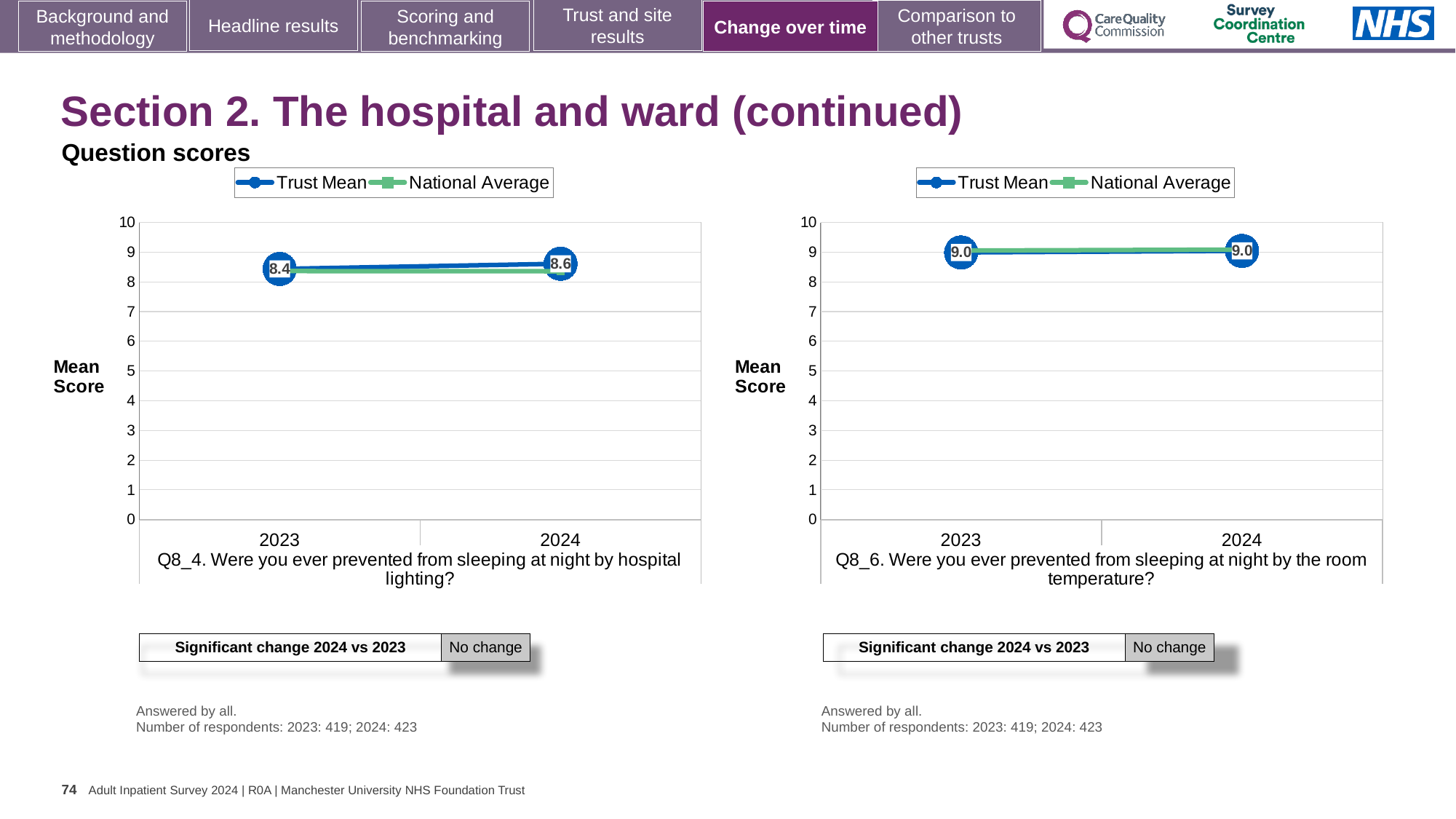
How many years are plotted on the x axis of the Q8_4 chart on the left? 2 In the Q8_4 chart on the left, is the National Average for 2023 greater or less than 8? greater How many series does the legend of the Q8_6 chart on the right list? 2 In the Q8_6 chart on the right, does the Trust Mean change between 2023 and 2024? No, it stays at 9.0 In the Q8_4 chart on the left, does the Trust Mean rise or fall from 2023 to 2024? rise In the Q8_4 chart on the left, what is the Trust Mean for 2023? 8.4 In the Q8_6 chart on the right, is the National Average for 2024 greater or less than 8? greater In the Q8_4 chart on the left, what is the Trust Mean for 2024? 8.6 In the Q8_4 chart on the left, which year has the higher Trust Mean, 2023 or 2024? 2024 What kind of chart is the Q8_4 chart on the left? Line chart In the Q8_4 chart on the left, what is the difference between the Trust Mean for 2024 and 2023? 0.2 In the Q8_6 chart on the right, what is the Trust Mean for 2024? 9.0